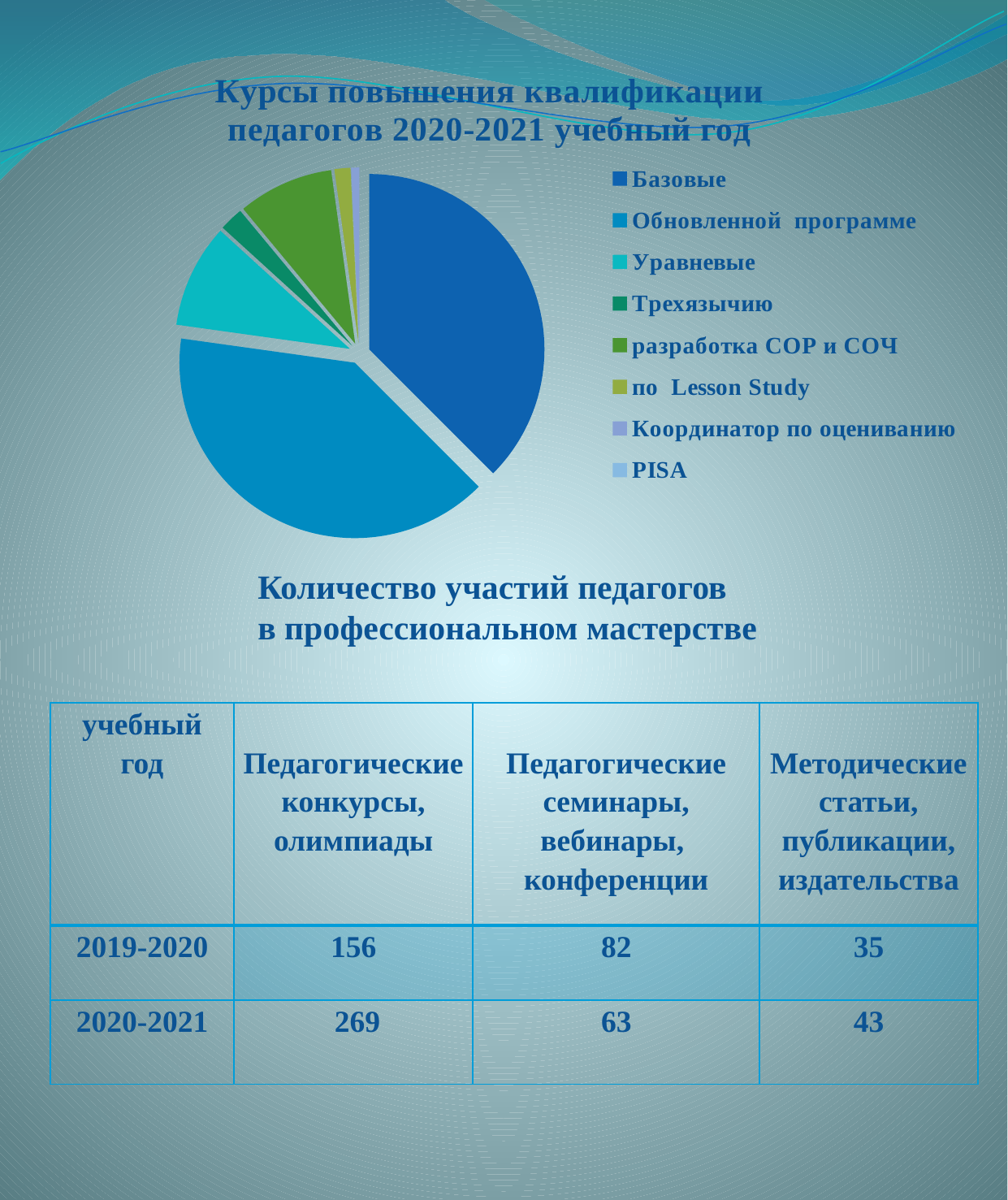
In the pie chart, which slice is larger: Уравневые or Трехязычию? Уравневые What is the title of the pie chart? Курсы повышения квалификации педагогов 2020-2021 учебный год In the pie chart, which slice is larger: разработка СОР и СОЧ or по Lesson Study? разработка СОР и СОЧ Which legend entry is listed first in the pie chart's legend? Базовые In the pie chart, which slice is larger: Обновленной программе or Трехязычию? Обновленной программе What kind of chart is shown on the slide? pie chart How many categories does the pie chart show? 8